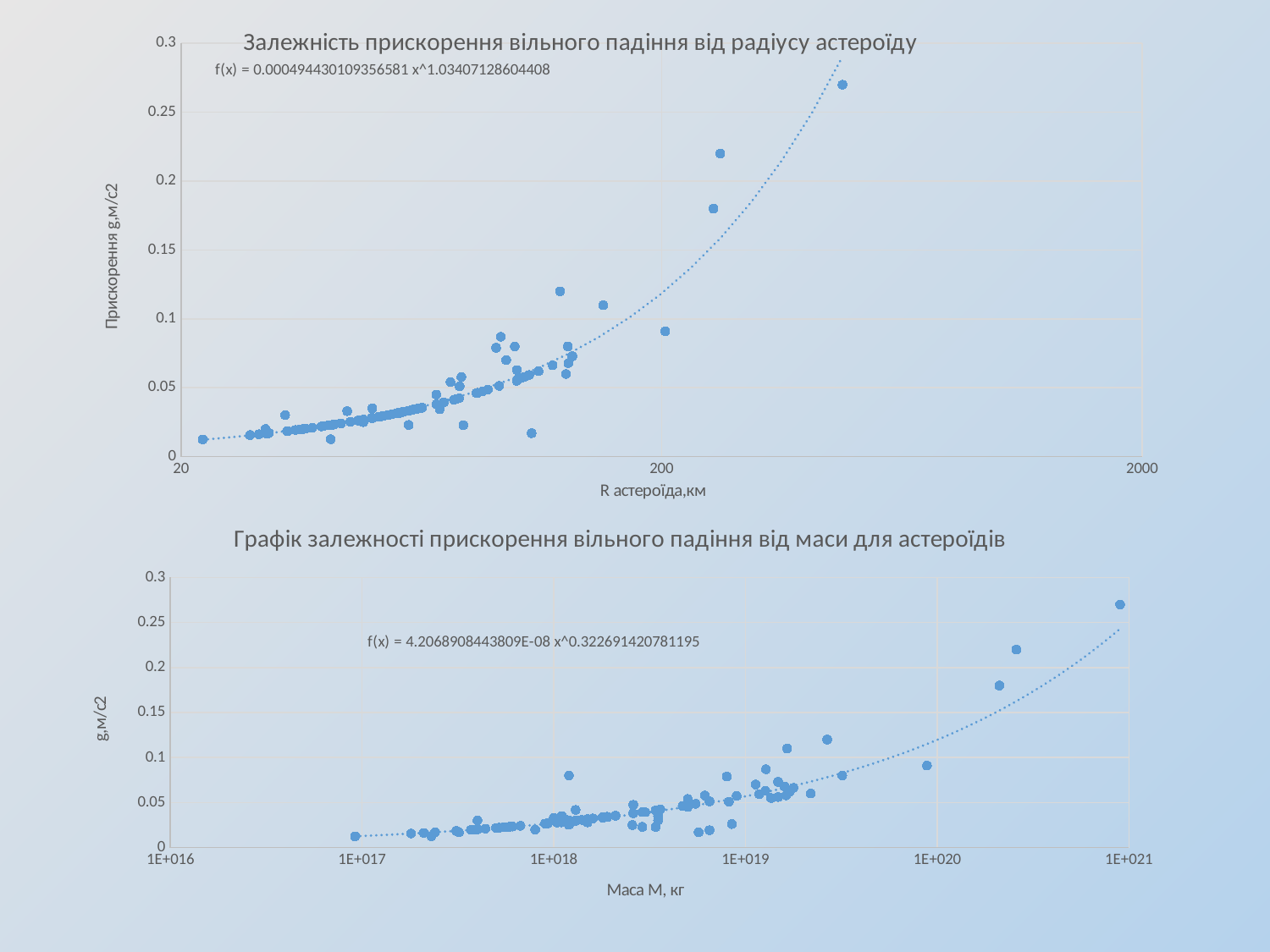
What is the trendline equation shown on the top chart? f(x) = 0.000494430109356581 x^1.03407128604408 What kind of chart is the bottom chart, titled "Графік залежності прискорення вільного падіння від маси для астероїдів"? scatter chart In the bottom chart, do the plotted values of g generally rise or fall as the mass increases along the x axis? rise In the bottom chart, is the point plotted near 1E+020 on the x axis greater or less than 0.1 on the y axis? less What is the trendline equation shown on the bottom chart? f(x) = 4.2068908443809E-08 x^0.322691420781195 What kind of chart is the top chart, titled "Залежність прискорення вільного падіння від радіусу астероїду"? scatter chart In the top chart, is the highest plotted point greater or less than 0.25 on the y axis? greater What is the x-axis title of the top chart? R астероїда,км What is the x-axis title of the bottom chart? Маса M, кг In the bottom chart, is the highest plotted point greater or less than 0.25 on the y axis? greater In the top chart, do the plotted values of acceleration generally rise or fall as the asteroid radius increases along the x axis? rise